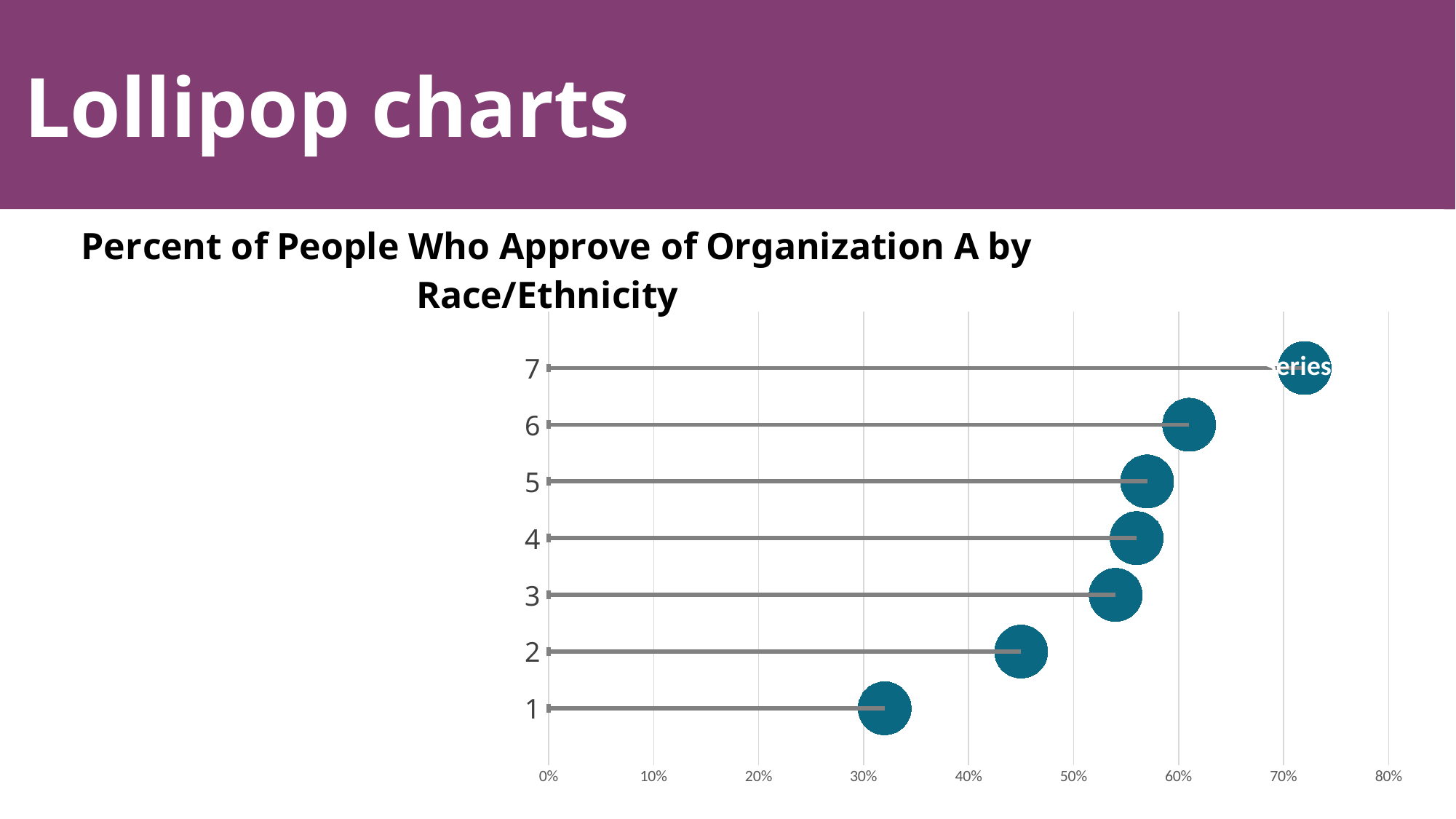
Is the value for category 6 greater or less than 50%? greater Is the value for category 2 greater or less than 50%? less Do the values increase or decrease going from category 1 up to category 7? increase Is the value for category 7 greater or less than 60%? greater Which has the larger value, category 6 or category 7? 7 Which category has the highest value in the chart? 7 Which category has the lowest value in the chart? 1 Which has the larger value, category 2 or category 3? 3 What kind of chart is shown on the slide? Lollipop chart How many categories are plotted in the chart? 7 What is the title of the chart? Percent of People Who Approve of Organization A by Race/Ethnicity